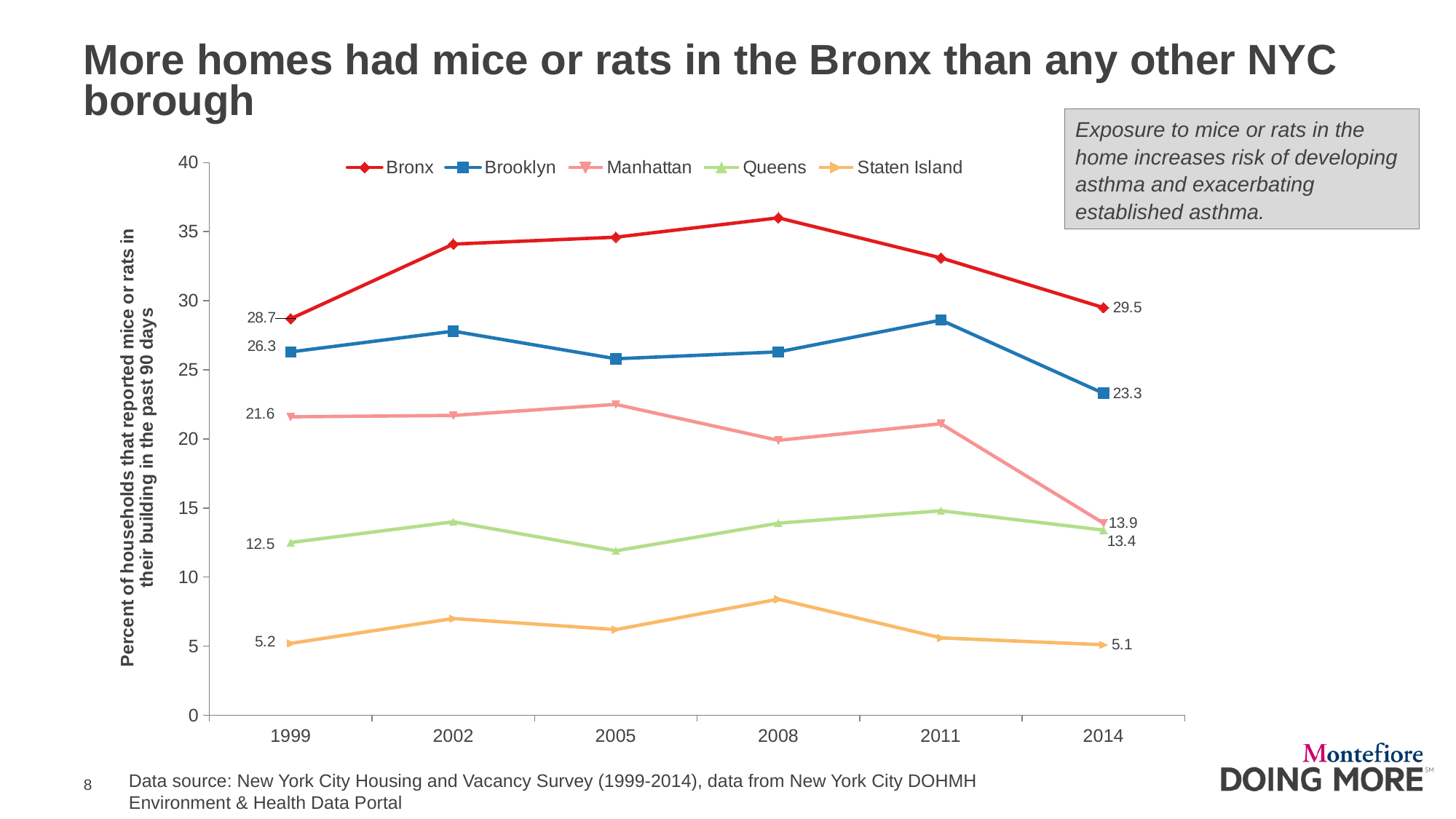
How many years are plotted along the x axis? 6 What was the value for Brooklyn in 2014? 23.3 What was the value for Staten Island in 1999? 5.2 Is the value for the Bronx in 2008 greater or less than 35? greater How many series does the legend list? 5 Which borough had the lowest value in 1999? Staten Island What is the difference between the Manhattan values in 1999 and 2014? 7.7 Which borough had the highest value in 2014? Bronx What was the value for Manhattan in 2014? 13.9 Which is larger in 2014, the value for Queens or the value for Manhattan? Manhattan What was the value for the Bronx in 1999? 28.7 What type of chart is shown on the slide? line chart